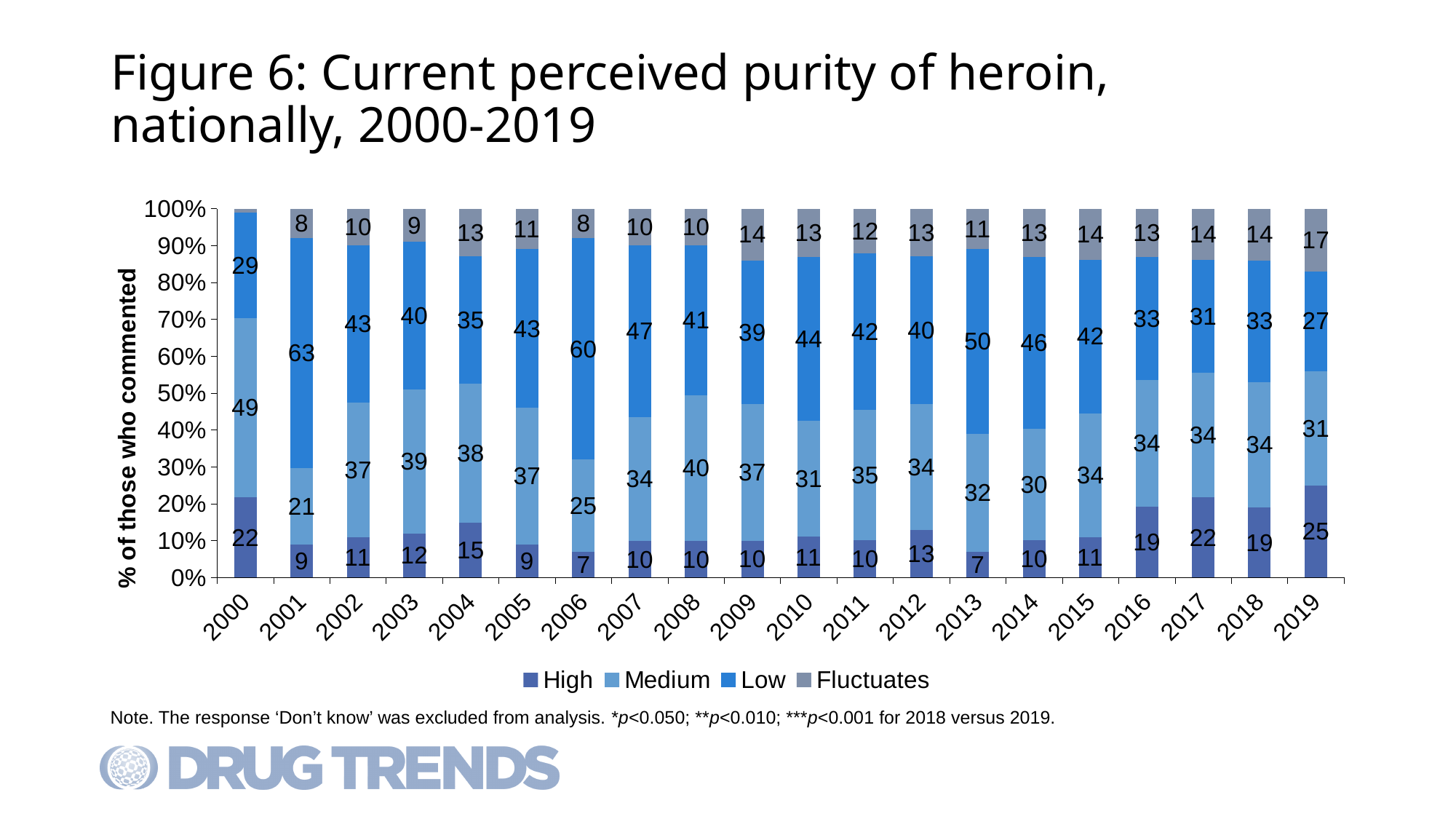
Which is larger in 2019, the High value or the Low value? Low What is the value for High in 2019? 25 What kind of chart is shown on the slide? Stacked bar chart What is the difference between the Low value in 2013 and the Low value in 2019? 23 What is the value for Fluctuates in 2019? 17 In which year is the Low series at its highest? 2001 Does the Low series rise or fall from 2013 to 2017? Fall How many series does the legend list? 4 What percentage of those who commented perceived heroin purity as Low in 2001? 63 How many years are shown on the x axis? 20 In which year is the Medium series at its lowest? 2001 What is the value for Medium in 2000? 49